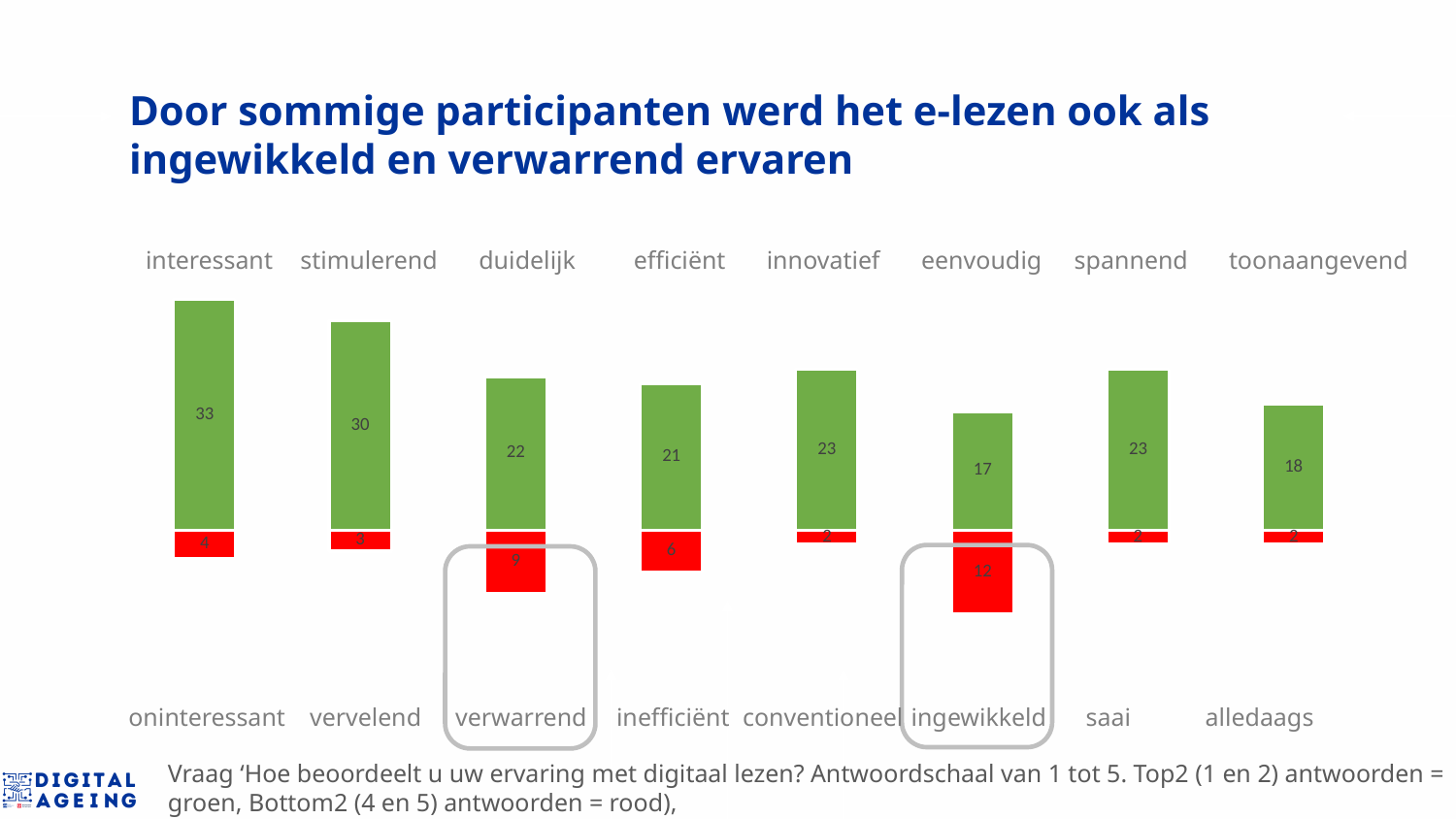
What type of chart is shown on the slide? bar chart Which attribute has the highest green (Top2) value? interessant Which attribute has the lowest green (Top2) value? eenvoudig Which attribute has the largest red (Bottom2) value? ingewikkeld What is the red (Bottom2) value for 'verwarrend'? 9 What is the difference between the green values for 'interessant' and 'stimulerend'? 3 What is the red (Bottom2) value for 'ingewikkeld'? 12 How many attribute pairs (bars) are shown in the chart? 8 What is the green (Top2) value for 'interessant'? 33 What is the green value for 'eenvoudig'? 17 What is the difference between the red values for 'ingewikkeld' and 'verwarrend'? 3 Which has a larger green value, 'duidelijk' or 'efficiënt'? duidelijk